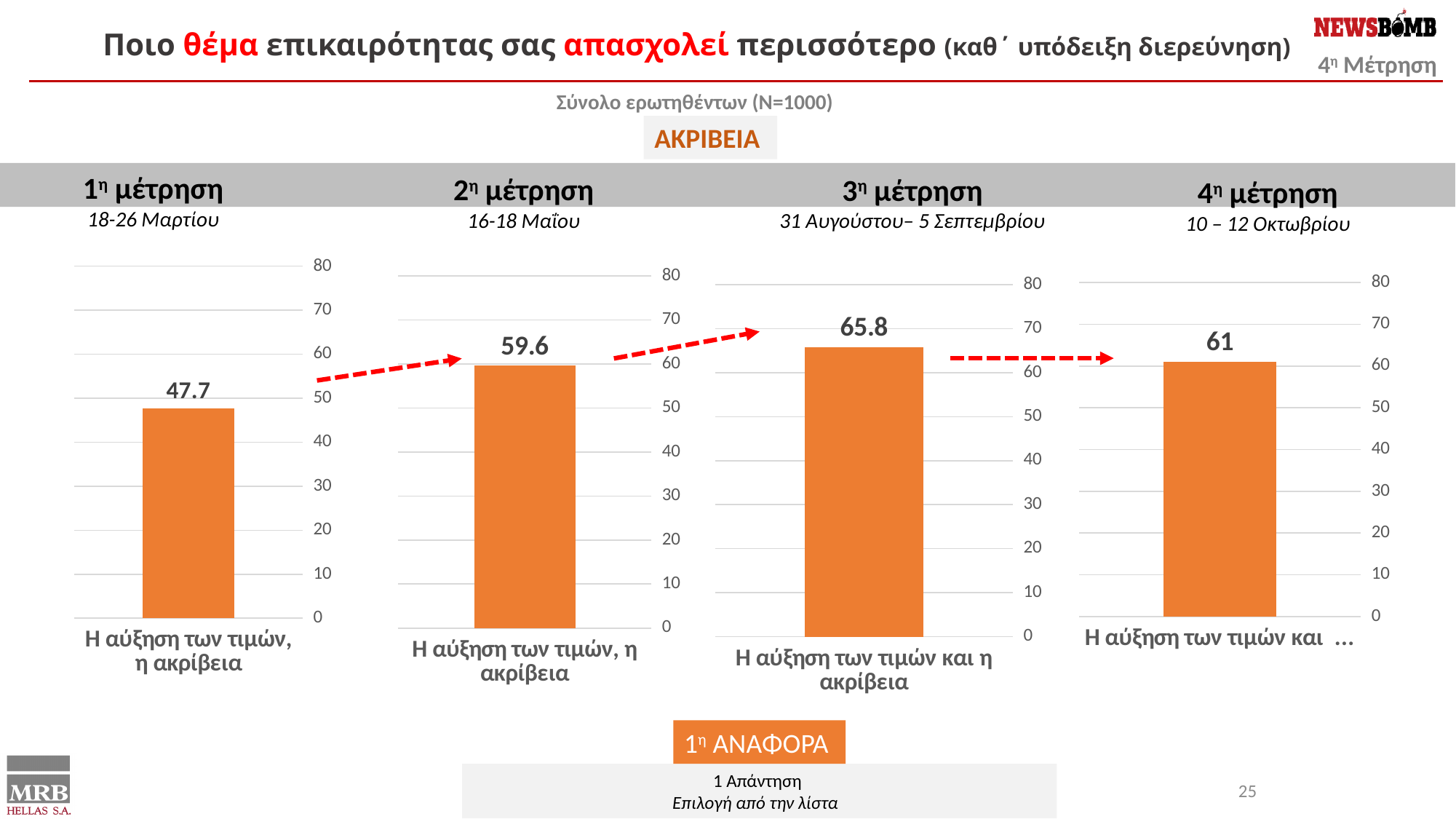
What is the difference between the value in the "3η μέτρηση" chart and the value in the "4η μέτρηση" chart? 4.8 Across the four charts on the slide, which measurement (μέτρηση) shows the highest value? 3η μέτρηση What is the difference between the value in the "2η μέτρηση" chart and the value in the "1η μέτρηση" chart? 11.9 What kind of chart is used under each measurement heading on the slide? bar chart In the chart under "3η μέτρηση" (31 Αυγούστου – 5 Σεπτεμβρίου), what value is shown on the bar? 65.8 In the chart under "1η μέτρηση", is the bar value greater or less than 50? less In the chart under "2η μέτρηση" (16-18 Μαΐου), what value is shown on the bar? 59.6 In the chart under "1η μέτρηση" (18-26 Μαρτίου), what is the value for "Η αύξηση των τιμών, η ακρίβεια"? 47.7 How many bars does the chart under "3η μέτρηση" contain? 1 Which is larger: the value in the "4η μέτρηση" chart or the value in the "2η μέτρηση" chart? 4η μέτρηση In the chart under "4η μέτρηση" (10 – 12 Οκτωβρίου), what value is shown on the bar? 61 Across the four charts on the slide, which measurement (μέτρηση) shows the lowest value? 1η μέτρηση